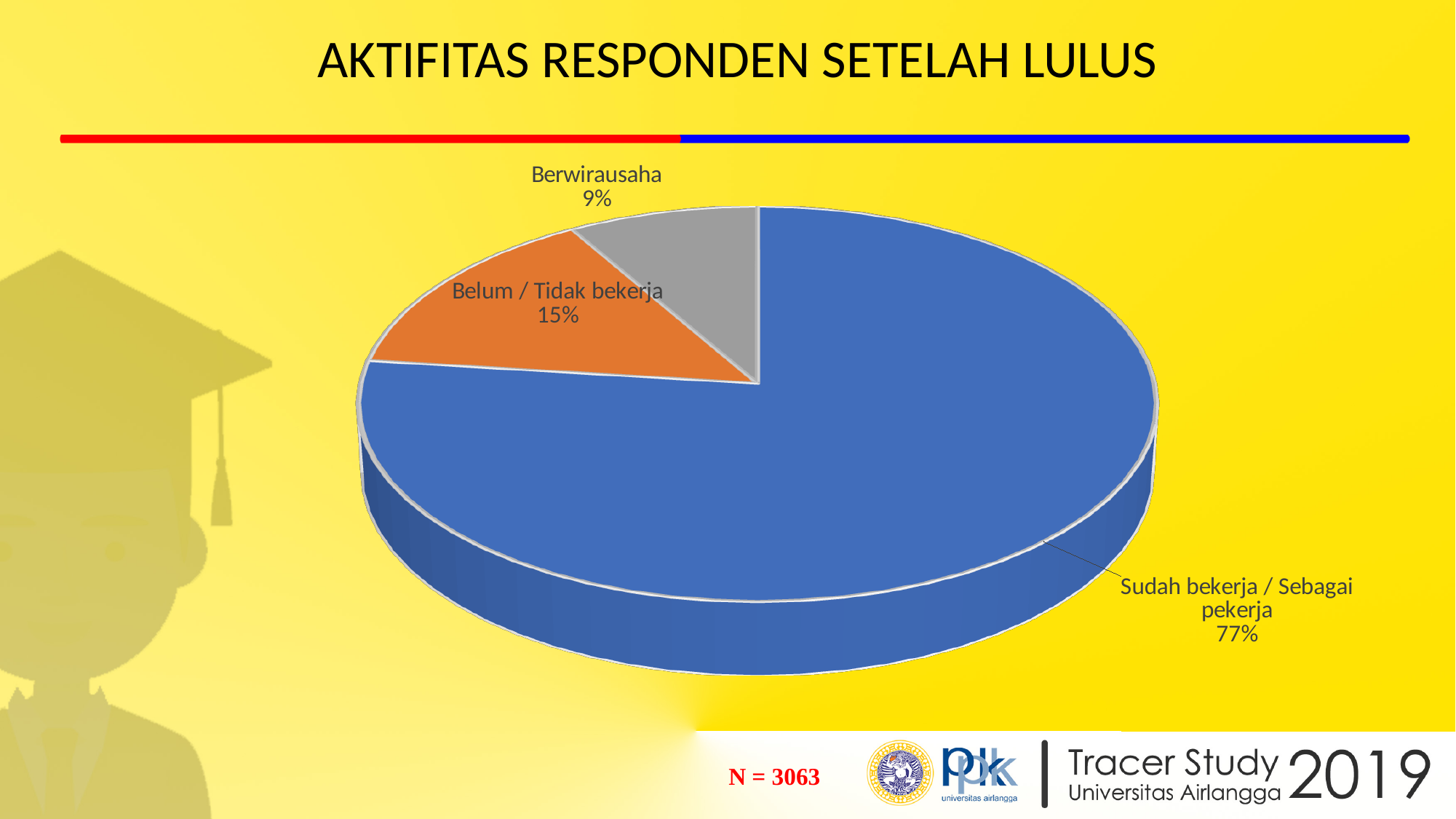
What percentage of respondents are in the 'Berwirausaha' category? 9% What kind of chart is shown on the slide? pie chart How many categories (slices) does the pie chart have? 3 Which is larger, the share for 'Belum / Tidak bekerja' or the share for 'Berwirausaha'? Belum / Tidak bekerja Which category has the largest share of the pie? Sudah bekerja / Sebagai pekerja What is the difference in percentage points between 'Belum / Tidak bekerja' and 'Berwirausaha'? 6 Which category has the smallest share of the pie? Berwirausaha What is the title of the chart on the slide? AKTIFITAS RESPONDEN SETELAH LULUS What is the difference in percentage points between 'Sudah bekerja / Sebagai pekerja' and 'Belum / Tidak bekerja'? 62 What percentage of respondents are in the 'Sudah bekerja / Sebagai pekerja' category? 77% What percentage of respondents are in the 'Belum / Tidak bekerja' category? 15% What colour is the 'Belum / Tidak bekerja' slice? orange